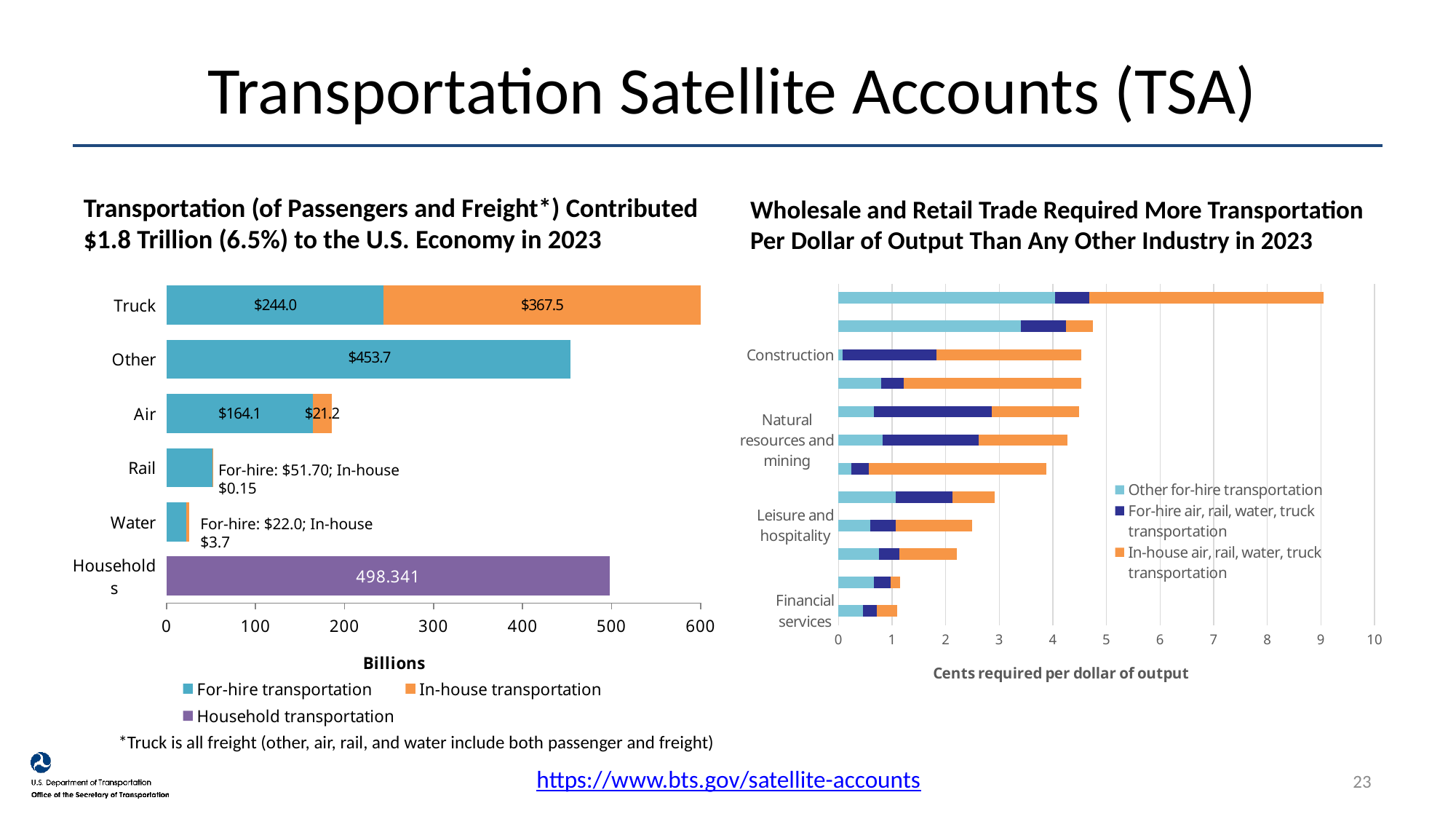
In the left chart, what is the In-house transportation value for Truck? $367.5 In the left chart, what is the In-house value for Rail? $0.15 In the left chart, what is the value shown for Households? 498.341 What kind of chart is the right chart? Bar chart What is the x-axis title of the right chart? Cents required per dollar of output In the left chart, which category has the largest For-hire transportation value? Other In the left chart, which category has the smallest For-hire transportation value? Water In the left chart, what is the For-hire transportation value for Truck? $244.0 In the right chart, is the total value for Financial services greater or less than 2? less In the left chart, what is the total of the Truck bar (For-hire plus In-house)? $611.5 How many series does the legend of the left chart list? 3 In the left chart, what is the difference between the In-house and For-hire values for Truck? $123.5